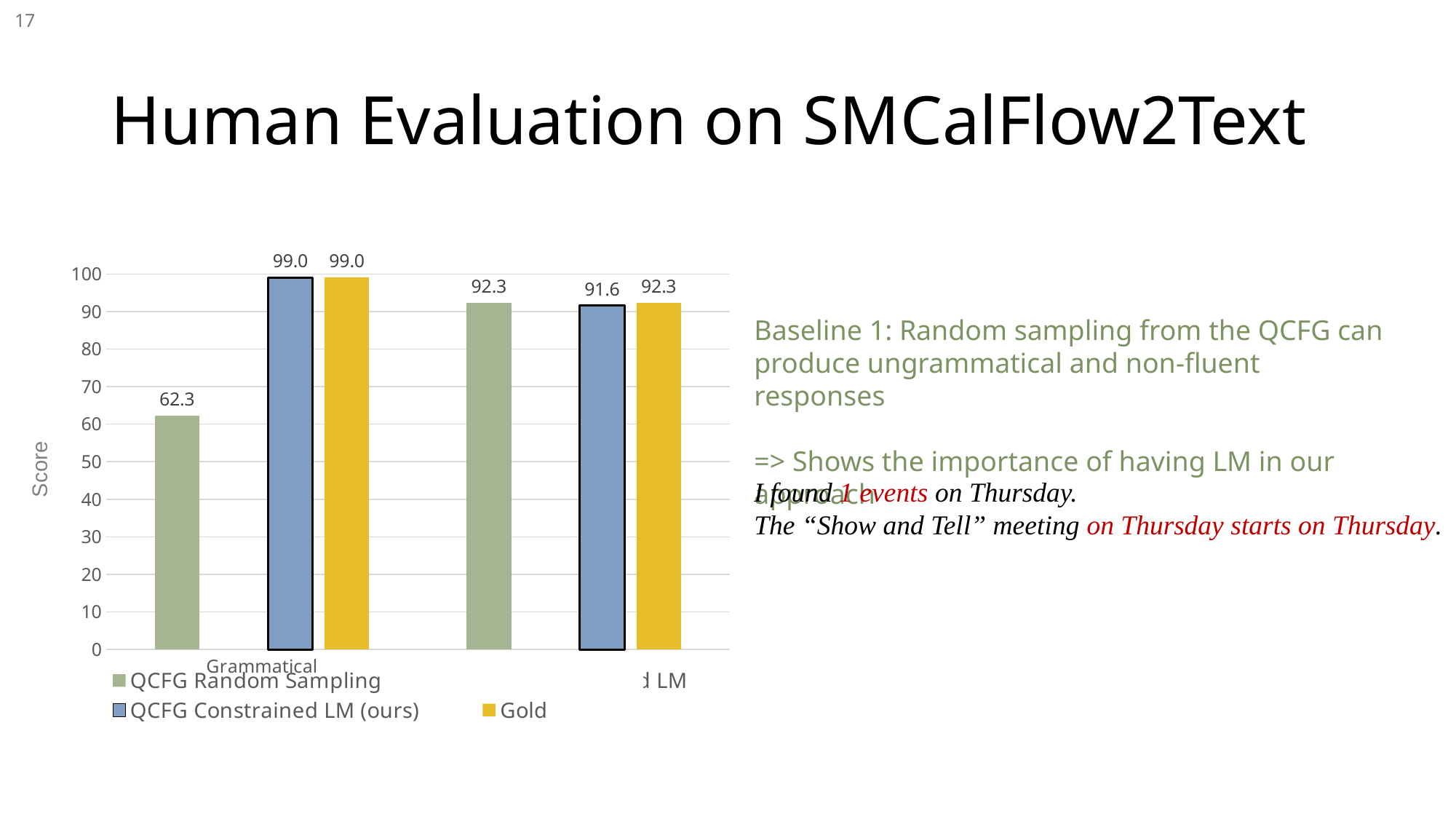
What is the Gold score in the Grammatical category? 99.0 What kind of chart is shown on the slide? bar chart In the Grammatical category, what is the difference between the Gold score and the QCFG Random Sampling score? 36.7 In the Grammatical category, which scores higher: QCFG Random Sampling or QCFG Constrained LM (ours)? QCFG Constrained LM (ours) Is the QCFG Random Sampling score in the Grammatical category greater or less than 70? less What is the score for QCFG Random Sampling in the Grammatical category? 62.3 In the right-hand group of bars, what is the difference between the Gold score and the QCFG Constrained LM (ours) score? 0.7 What is the score for QCFG Constrained LM (ours) in the Grammatical category? 99.0 Which series has the lowest score in the Grammatical category? QCFG Random Sampling How many series does the legend list? 4 What is the score for QCFG Constrained LM (ours) in the right-hand group of bars? 91.6 What is the label on the vertical axis of the chart? Score